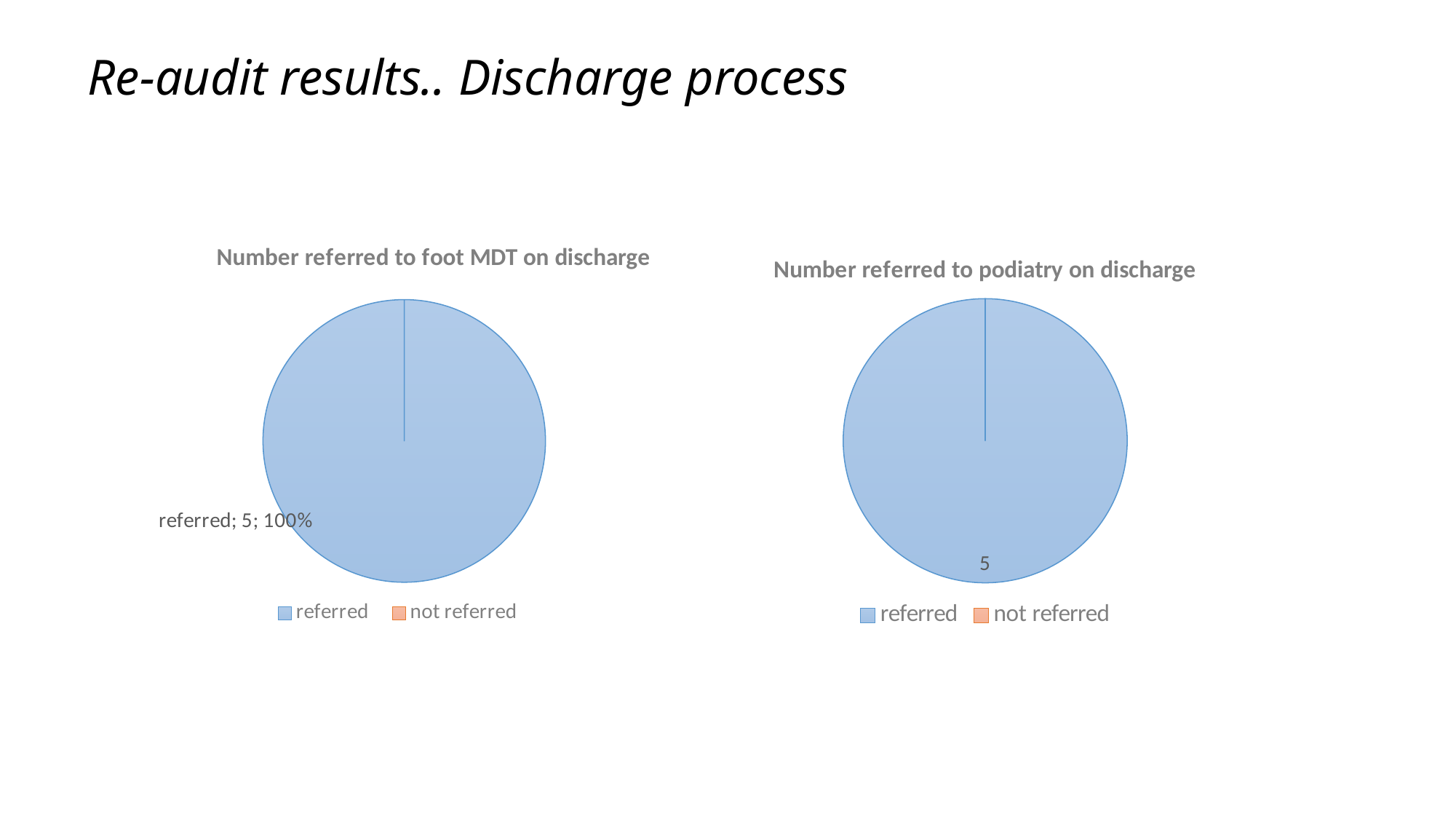
In the chart titled "Number referred to foot MDT on discharge", what is the value for "referred"? 5 What is the title of the chart on the left of the slide? Number referred to foot MDT on discharge In the chart titled "Number referred to foot MDT on discharge", what share of the pie does "referred" take? 100% What kind of chart is "Number referred to foot MDT on discharge"? Pie chart In the chart titled "Number referred to foot MDT on discharge", how many entries does the legend list? 2 In the chart titled "Number referred to podiatry on discharge", what colour represents "not referred" in the legend? Orange In the chart titled "Number referred to podiatry on discharge", how many entries does the legend list? 2 In the chart titled "Number referred to podiatry on discharge", what is the value for "referred"? 5 In the chart titled "Number referred to podiatry on discharge", which category is the largest? referred What kind of chart is "Number referred to podiatry on discharge"? Pie chart In the chart titled "Number referred to foot MDT on discharge", which category is the largest? referred In the chart titled "Number referred to podiatry on discharge", which category is larger, "referred" or "not referred"? referred